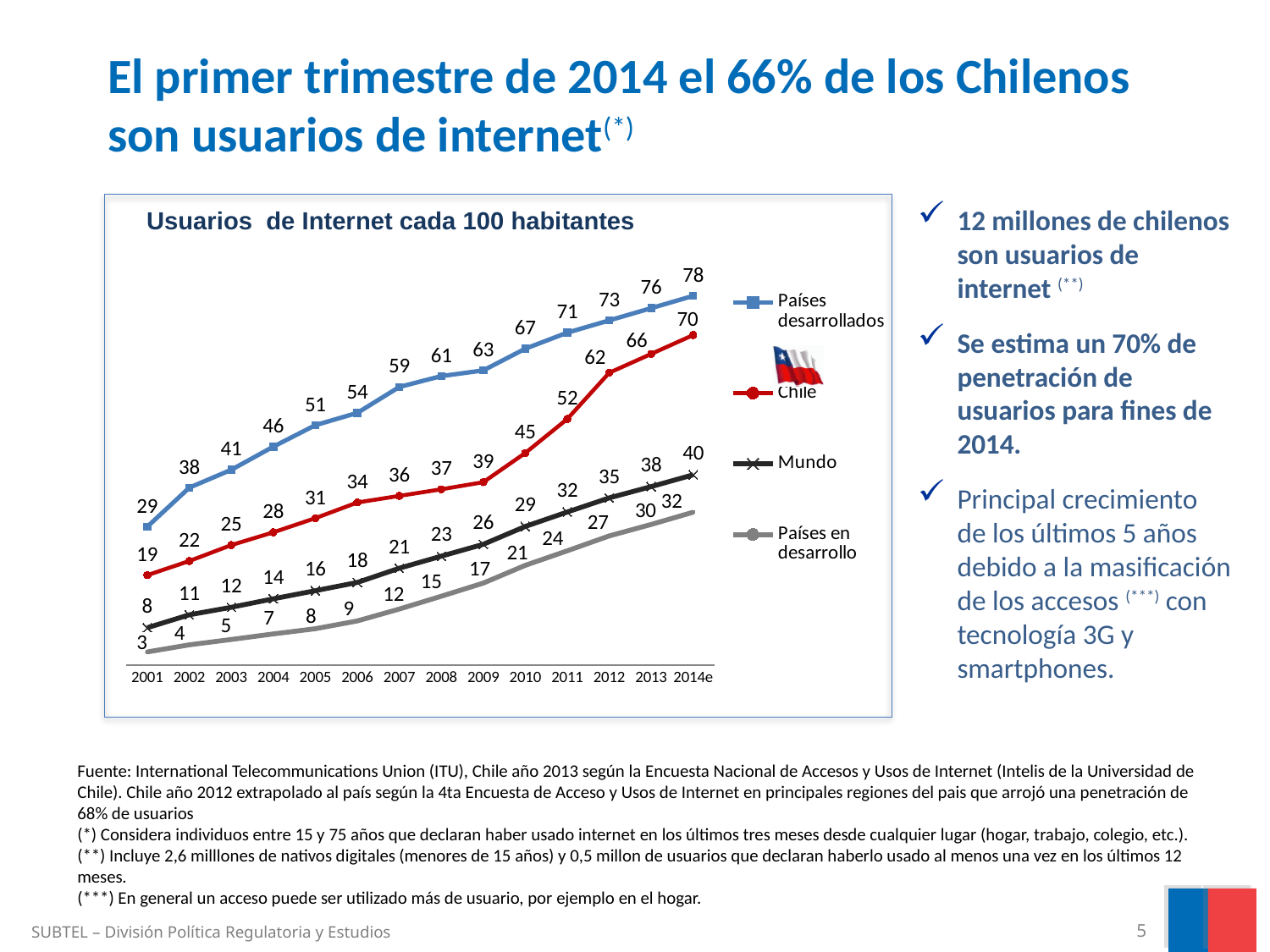
What is the value for Países desarrollados in 2001? 29 What is the title of the chart? Usuarios de Internet cada 100 habitantes How many series does the chart legend list? 4 What is the value for Países en desarrollo in 2007? 12 What is the value for Mundo in 2009? 26 How many years are shown on the x axis of the chart? 14 Which series has the lowest value in 2001? Países en desarrollo Does the Chile series rise or fall from 2001 to 2014e? Rise What kind of chart is shown on the slide? Line chart What is the difference between the Chile value in 2014e and the Chile value in 2001? 51 What is the value for Chile in 2014e? 70 Which series has the highest value in 2014e? Países desarrollados